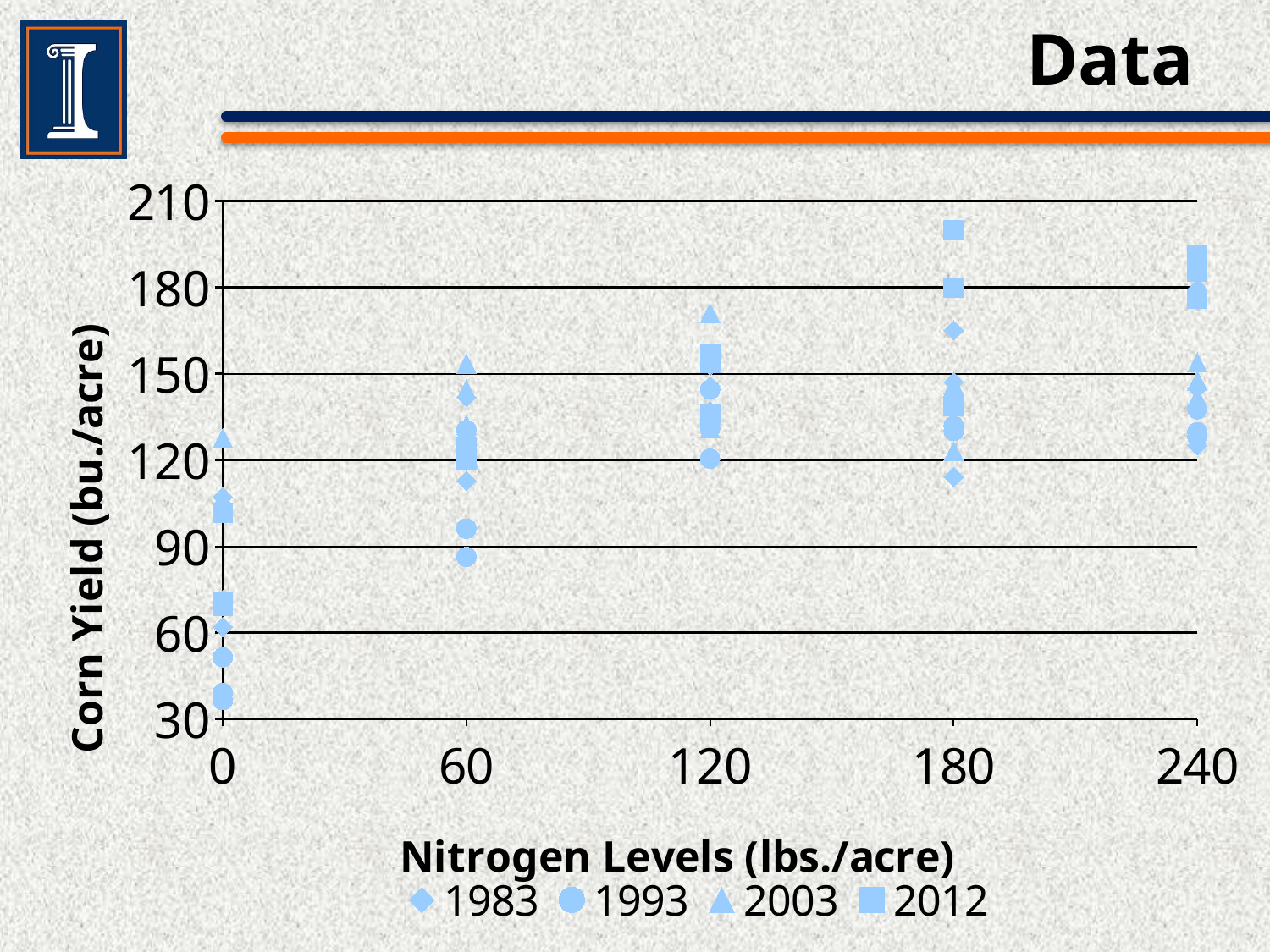
Is the lowest 1993 value at nitrogen level 0 greater or less than 60? less What is the title of the y axis? Corn Yield (bu./acre) At which nitrogen level is the lowest corn yield plotted? 0 Is the highest 2012 value at nitrogen level 180 greater or less than 180? greater Do corn yields generally rise or fall as nitrogen level increases along the x axis? rise How many series does the legend list? 4 Which years are listed in the legend? 1983, 1993, 2003, 2012 What kind of chart is shown on the slide? scatter chart Is the lowest plotted value at nitrogen level 240 greater or less than 120? greater How many nitrogen levels are plotted along the x axis? 5